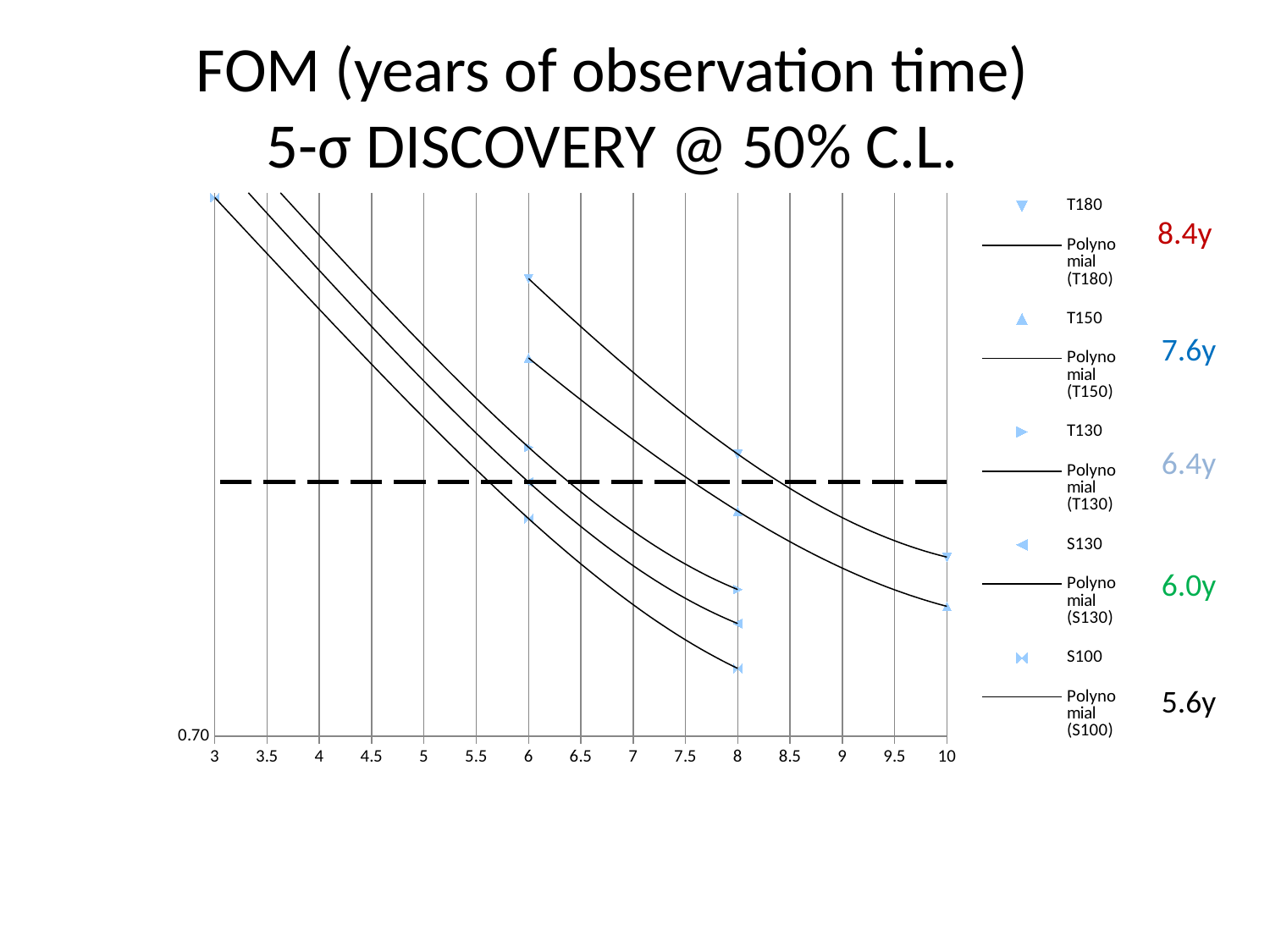
How many entries does the chart legend list? 10 At x = 6, which is larger: the value for T180 or the value for S100? T180 What is the lowest x-axis tick label shown on the chart? 3 What kind of chart is shown on the slide? scatter chart At x = 10, which is larger: the value for T180 or the value for T150? T180 What is the title of the chart on the slide? FOM (years of observation time) 5-σ DISCOVERY @ 50% C.L. At x = 8, which series has the highest plotted point? T180 How many tick labels are shown on the x axis? 15 At x = 8, which series has the lowest plotted point? S100 How many data points are plotted for the T180 series? 3 Do the plotted values rise or fall as the x-axis value increases? fall Is the value for T150 at x = 10 greater or less than 0.70? greater